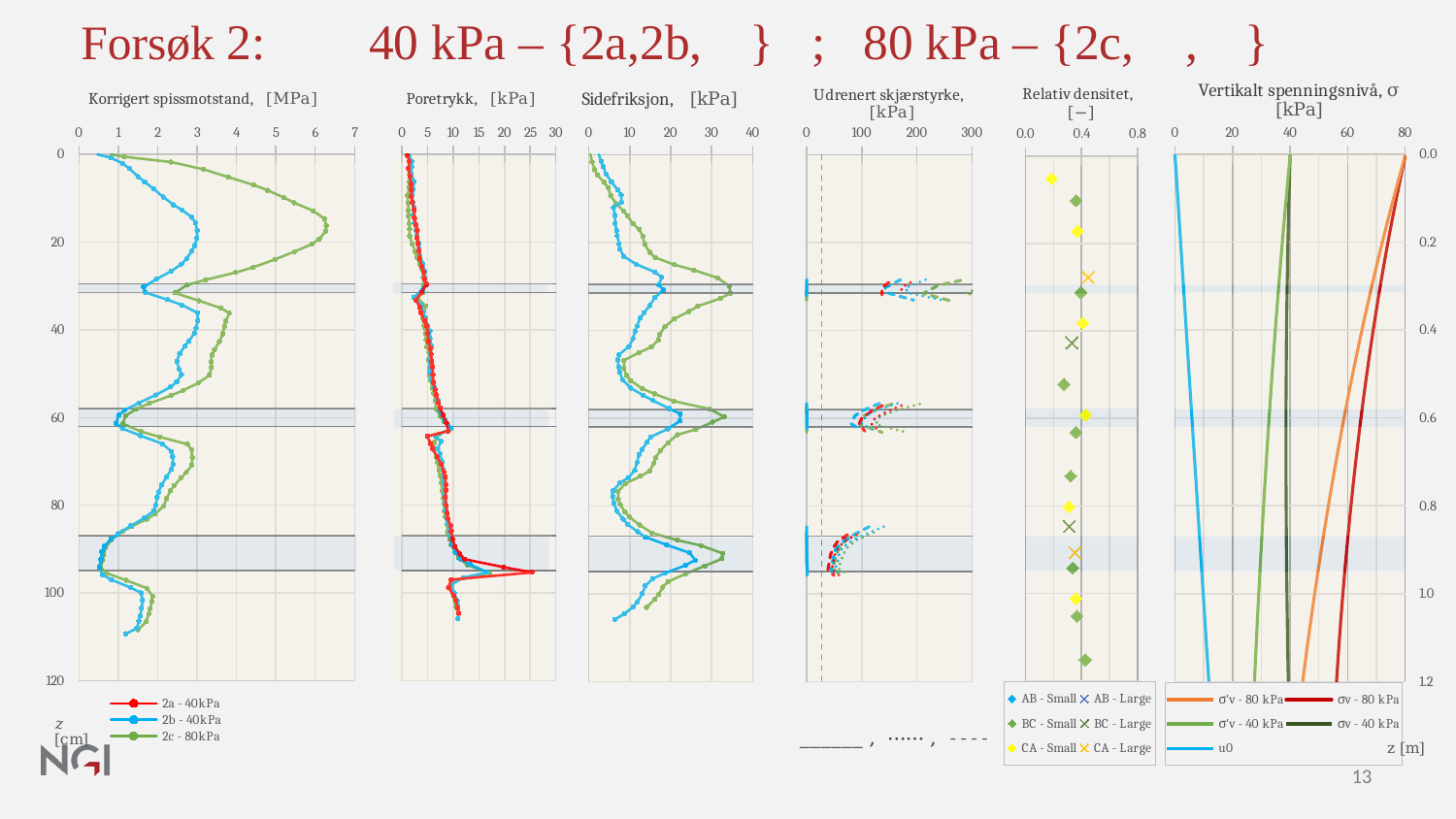
How many series does the legend of the 'Relativ densitet' chart list? 6 In the 'Korrigert spissmotstand' chart, is the peak value of the 2c - 80kPa series greater or less than 5 MPa? greater What kind of chart is the 'Korrigert spissmotstand' chart? line chart How many series does the legend of the 'Vertikalt spenningsnivå' chart list? 5 What is the unit shown on the x axis of the 'Korrigert spissmotstand' chart? MPa In the 'Vertikalt spenningsnivå' chart, what is the value of σ'v - 40 kPa at z = 0.0 m? 40 In the 'Vertikalt spenningsnivå' chart, which series has the larger value at z = 1.2 m, σv - 80 kPa or u0? σv - 80 kPa In the 'Korrigert spissmotstand' chart, which series has the larger value at about 17 cm depth, 2c - 80kPa or 2b - 40kPa? 2c - 80kPa In the 'Poretrykk' chart, is the peak value of the 2a - 40kPa series near 95 cm depth greater or less than 20 kPa? greater In the 'Sidefriksjon' chart, is the peak value of the 2c - 80kPa series near 30 cm depth greater or less than 30 kPa? greater How many series does the legend of the 'Korrigert spissmotstand' chart list? 3 In the 'Vertikalt spenningsnivå' chart, what is the value of σv - 80 kPa at z = 0.0 m? 80